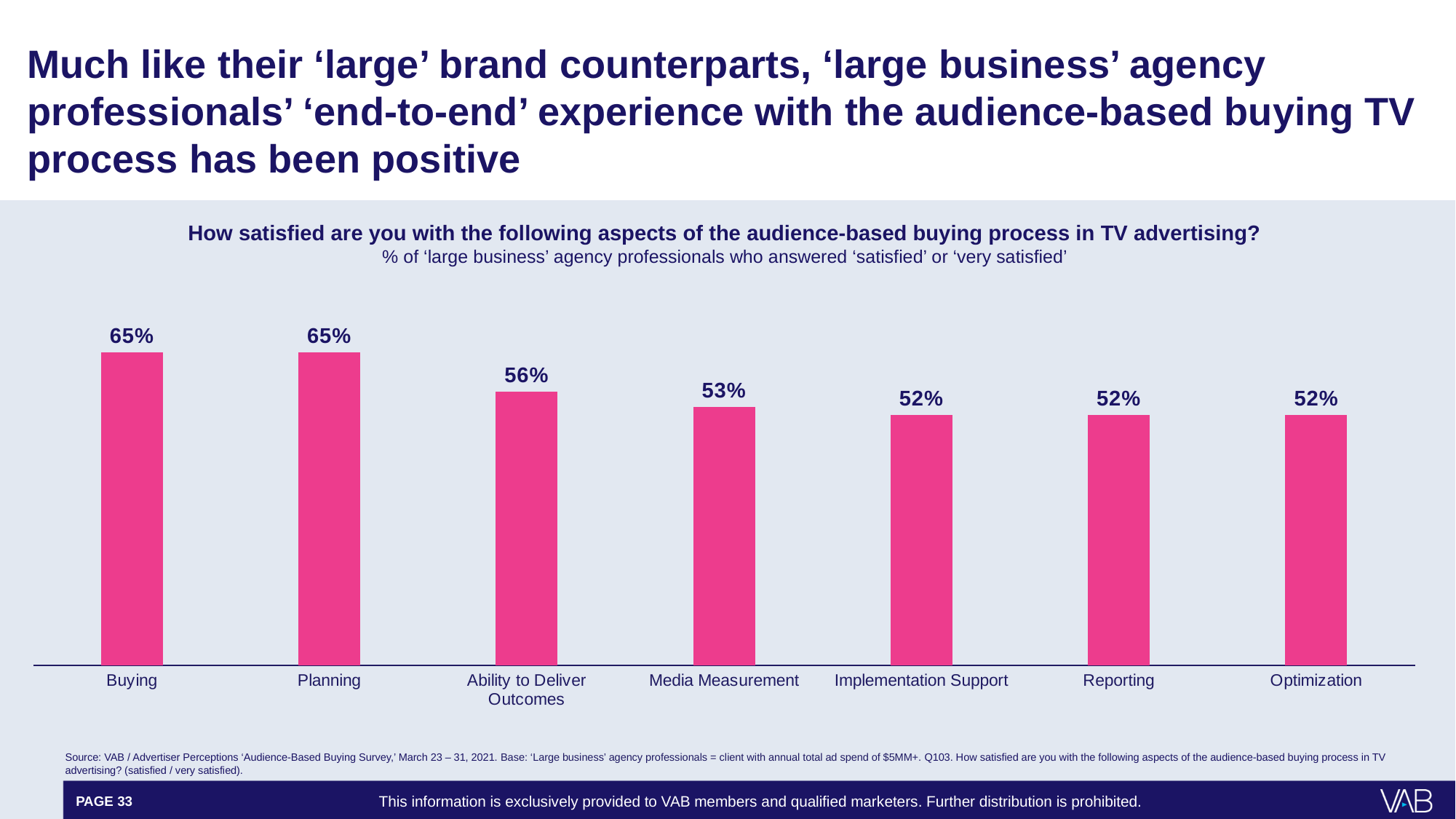
Which categories share the highest value in the chart? Buying and Planning What is the difference between the values for Buying and Reporting? 13 percentage points What is the lowest value shown in the chart? 52% Which has a larger value, Ability to Deliver Outcomes or Media Measurement? Ability to Deliver Outcomes Do the values rise or fall moving from left to right across the chart? Fall What is the value shown for Media Measurement? 53% What is the value shown for Ability to Deliver Outcomes? 56% What is the value shown for Optimization? 52% How many categories are shown in the chart? 7 What percentage of 'large business' agency professionals are satisfied with Buying? 65% What kind of chart is shown on the slide? Bar chart What is the difference between the values for Planning and Ability to Deliver Outcomes? 9 percentage points